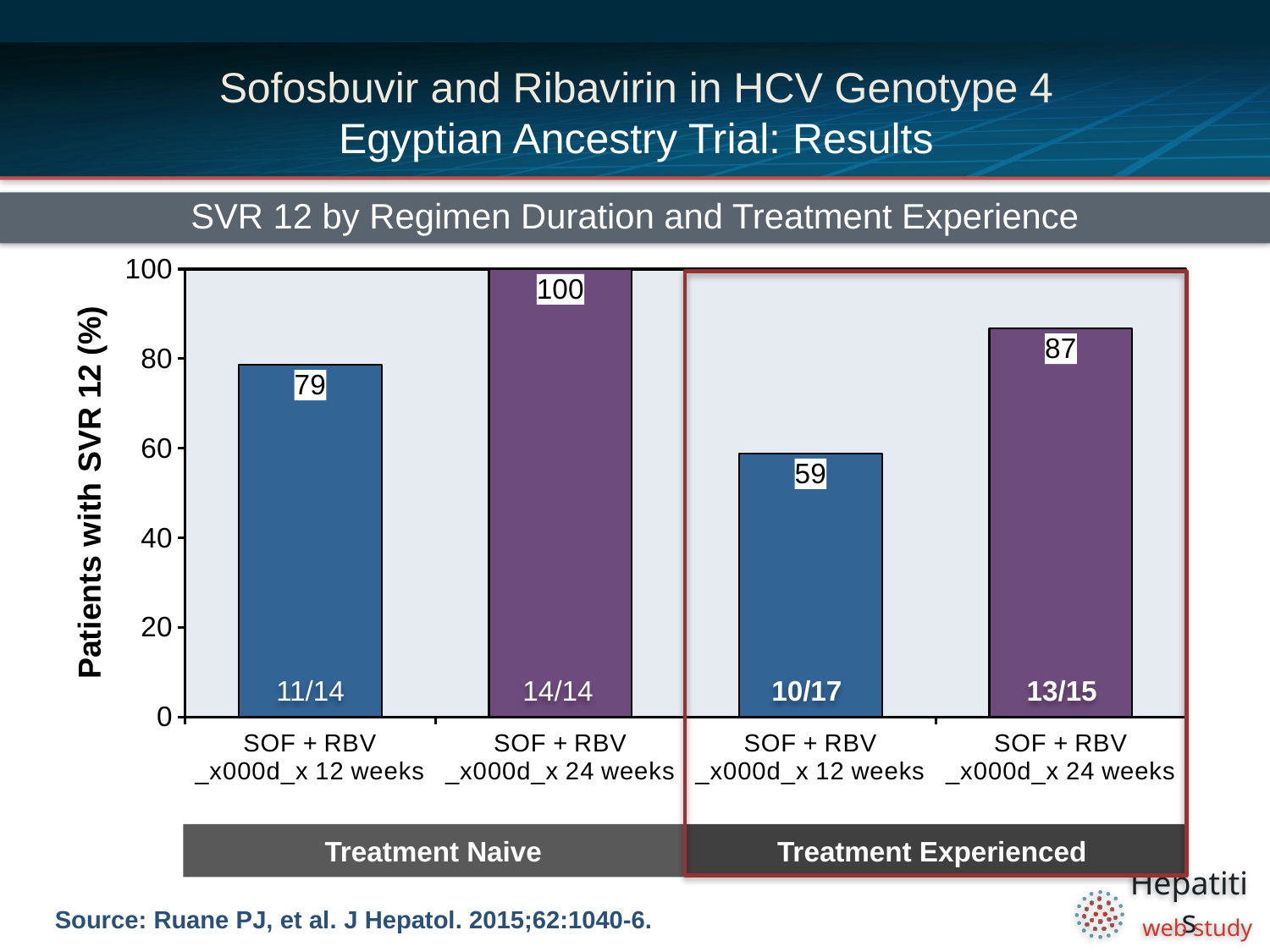
Which bar has the lowest SVR 12 rate? SOF + RBV 12 weeks, Treatment Experienced What is the SVR 12 rate for SOF + RBV 24 weeks in the Treatment Experienced group? 87 How many bars are shown in the chart? 4 Which is larger: the SVR 12 rate for Treatment Naive 12 weeks or Treatment Experienced 24 weeks? Treatment Experienced 24 weeks What kind of chart is shown on the slide? Bar chart Which bar has the highest SVR 12 rate? SOF + RBV 24 weeks, Treatment Naive How many patients achieved SVR 12 out of the total in the Treatment Naive SOF + RBV 24 weeks arm? 14/14 What is the difference in SVR 12 rate between the 24-week and 12-week arms in the Treatment Experienced group? 28 What is the title of the chart? SVR 12 by Regimen Duration and Treatment Experience What is the SVR 12 rate for SOF + RBV 12 weeks in the Treatment Experienced group? 59 What is the SVR 12 rate for SOF + RBV 12 weeks in the Treatment Naive group? 79 What is the label of the y-axis? Patients with SVR 12 (%)